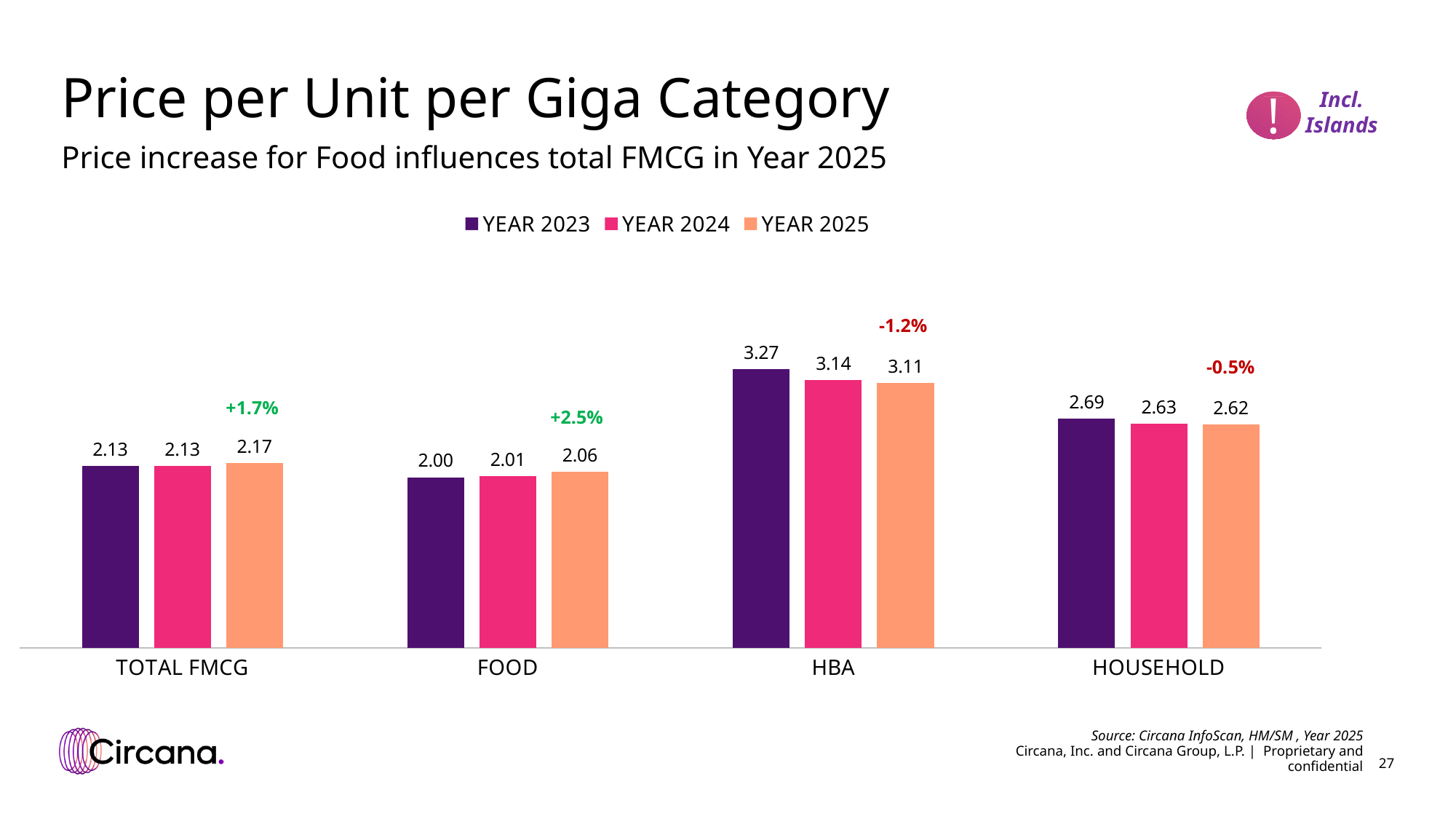
What is the difference between the YEAR 2023 and YEAR 2025 values for HBA? 0.16 Which category has the lowest price per unit in YEAR 2023? FOOD What kind of chart is shown on the slide? Bar chart How many categories are shown on the x axis? 4 Do the values for HOUSEHOLD rise or fall from YEAR 2023 to YEAR 2025? Fall How many series does the legend list? 3 What percentage change is shown above the YEAR 2025 bar for FOOD? +2.5% Which category has the highest price per unit in YEAR 2025? HBA What is the price per unit for HBA in YEAR 2023? 3.27 Which is larger: the YEAR 2025 value for TOTAL FMCG or the YEAR 2025 value for FOOD? TOTAL FMCG What is the price per unit for HOUSEHOLD in YEAR 2024? 2.63 What is the price per unit for FOOD in YEAR 2025? 2.06